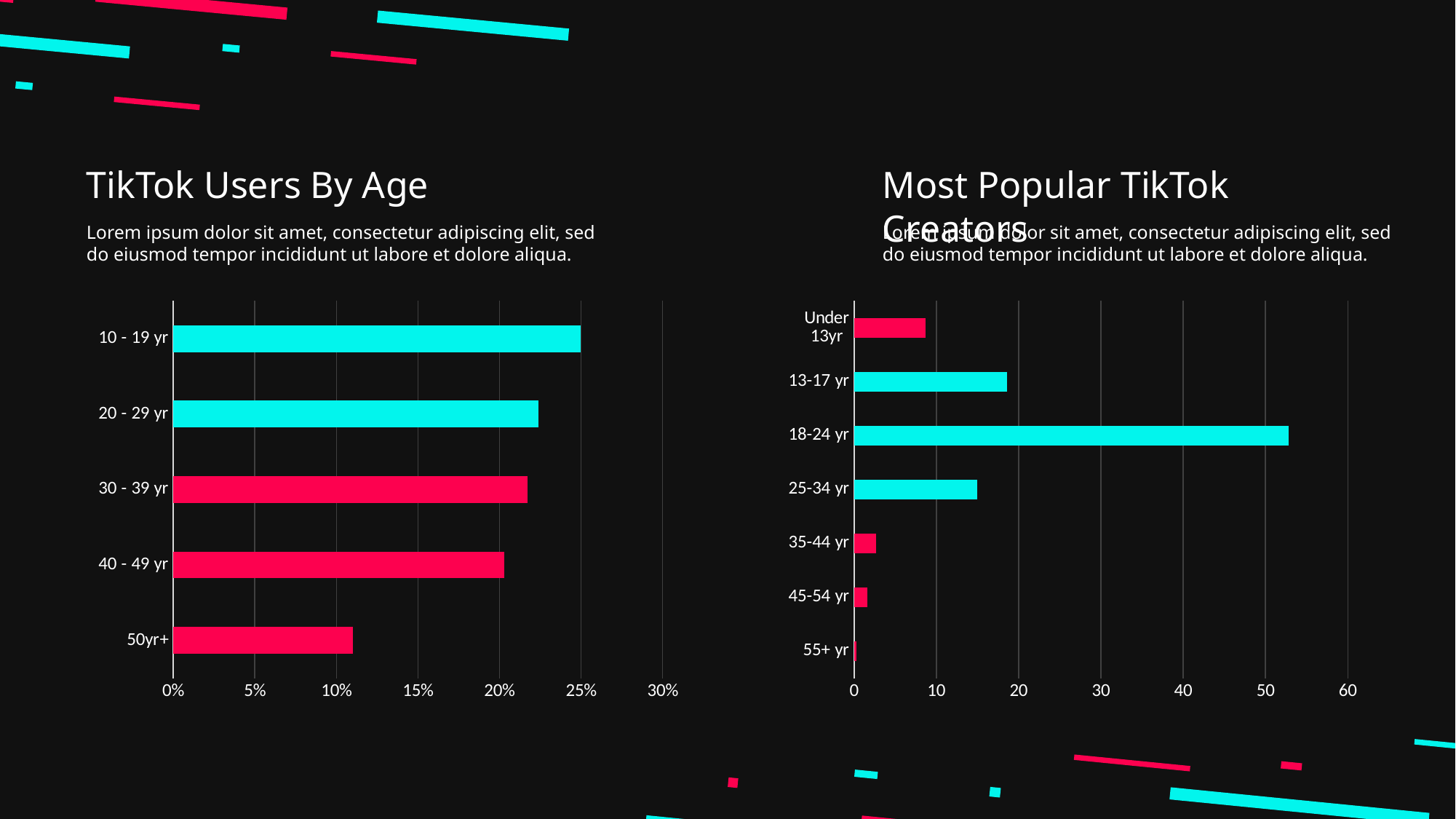
How many age categories does the 'Most Popular TikTok Creators' chart show? 7 In the 'Most Popular TikTok Creators' chart, which age group has the highest value? 18-24 yr In the 'TikTok Users By Age' chart, which age group has the lowest value? 50yr+ In the 'TikTok Users By Age' chart, is the value for 40 - 49 yr greater or less than 25%? less In the 'TikTok Users By Age' chart, which is larger, the value for 20 - 29 yr or the value for 50yr+? 20 - 29 yr In the 'TikTok Users By Age' chart, is the value for 50yr+ greater or less than 10%? greater In the 'Most Popular TikTok Creators' chart, is the value for 18-24 yr greater or less than 50? greater In the 'TikTok Users By Age' chart, what is the value for 10 - 19 yr? 25% How many age categories does the 'TikTok Users By Age' chart show? 5 In the 'Most Popular TikTok Creators' chart, which is larger, the value for 13-17 yr or the value for 25-34 yr? 13-17 yr What kind of chart is the 'TikTok Users By Age' chart? bar chart In the 'TikTok Users By Age' chart, which age group has the highest value? 10 - 19 yr